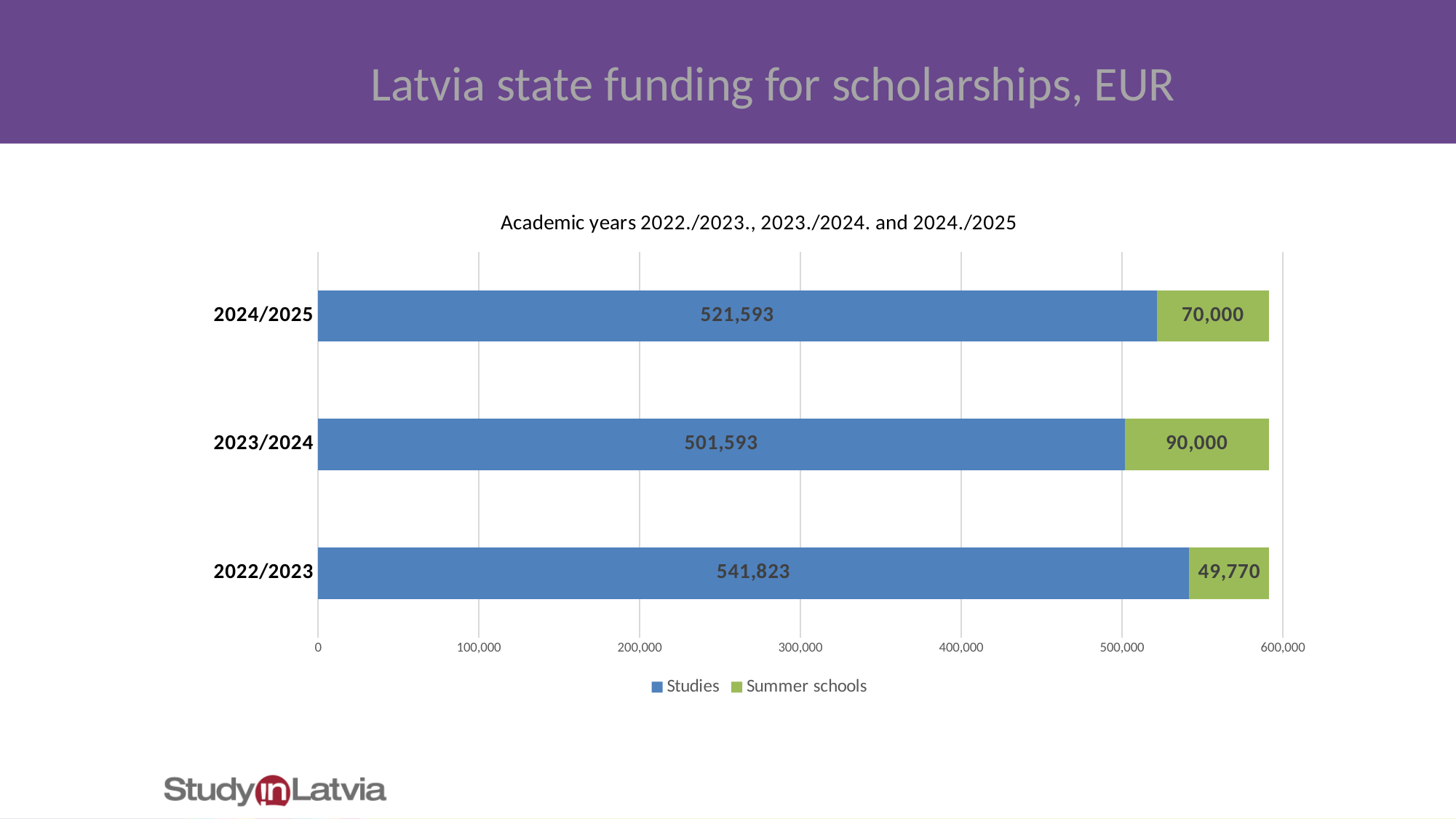
What is the total of the stacked bar for 2024/2025? 591,593 What is the difference between the Studies values for 2022/2023 and 2023/2024? 40,230 How many academic years are shown on the chart? 3 What is the Studies value for 2024/2025? 521,593 What kind of chart is shown on the slide? Stacked bar chart Which is larger, the Summer schools value for 2024/2025 or for 2023/2024? 2023/2024 How many series does the legend list? 2 What colour represents the Summer schools series? Green What is the Summer schools value for 2023/2024? 90,000 Which academic year has the lowest Summer schools value? 2022/2023 What is the Summer schools value for 2022/2023? 49,770 Which academic year has the highest Studies value? 2022/2023